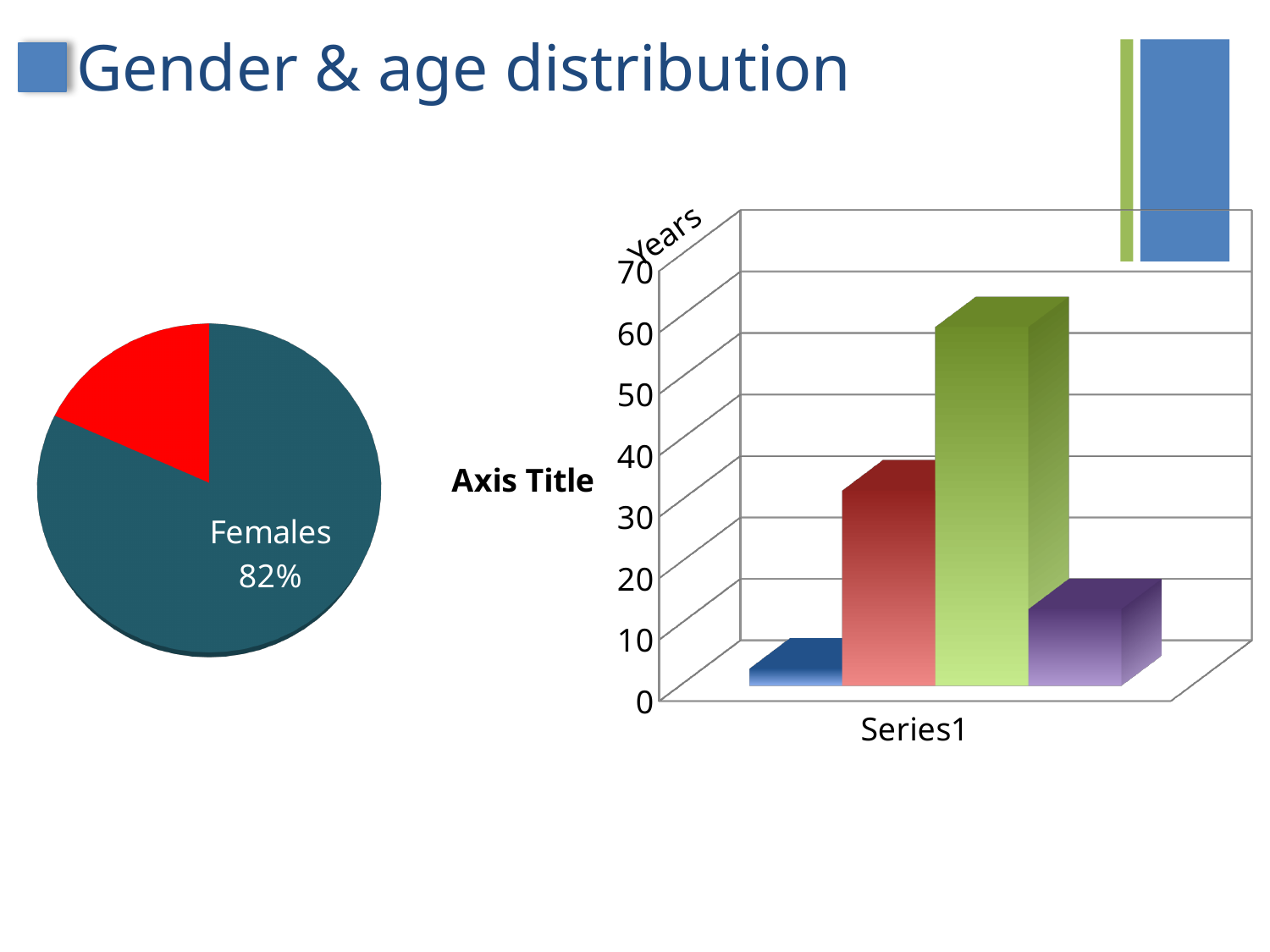
How many slices does the pie chart have? 2 In the bar chart on the right, which coloured bar is the shortest? the blue bar What label appears under the bars on the horizontal axis of the bar chart on the right? Series1 In the bar chart on the right, is the value of the green bar greater or less than 50? greater What kind of chart is the chart on the left of the slide? pie chart In the bar chart on the right, which coloured bar is the tallest? the green bar What kind of chart is the chart on the right of the slide? bar chart In the bar chart on the right, is the value of the red bar greater or less than 20? greater In the pie chart, what share of the pie is labelled Females? 82% How many bars are plotted in the bar chart on the right? 4 In the bar chart on the right, which is taller, the red bar or the purple bar? the red bar In the bar chart on the right, is the value of the blue bar greater or less than 10? less